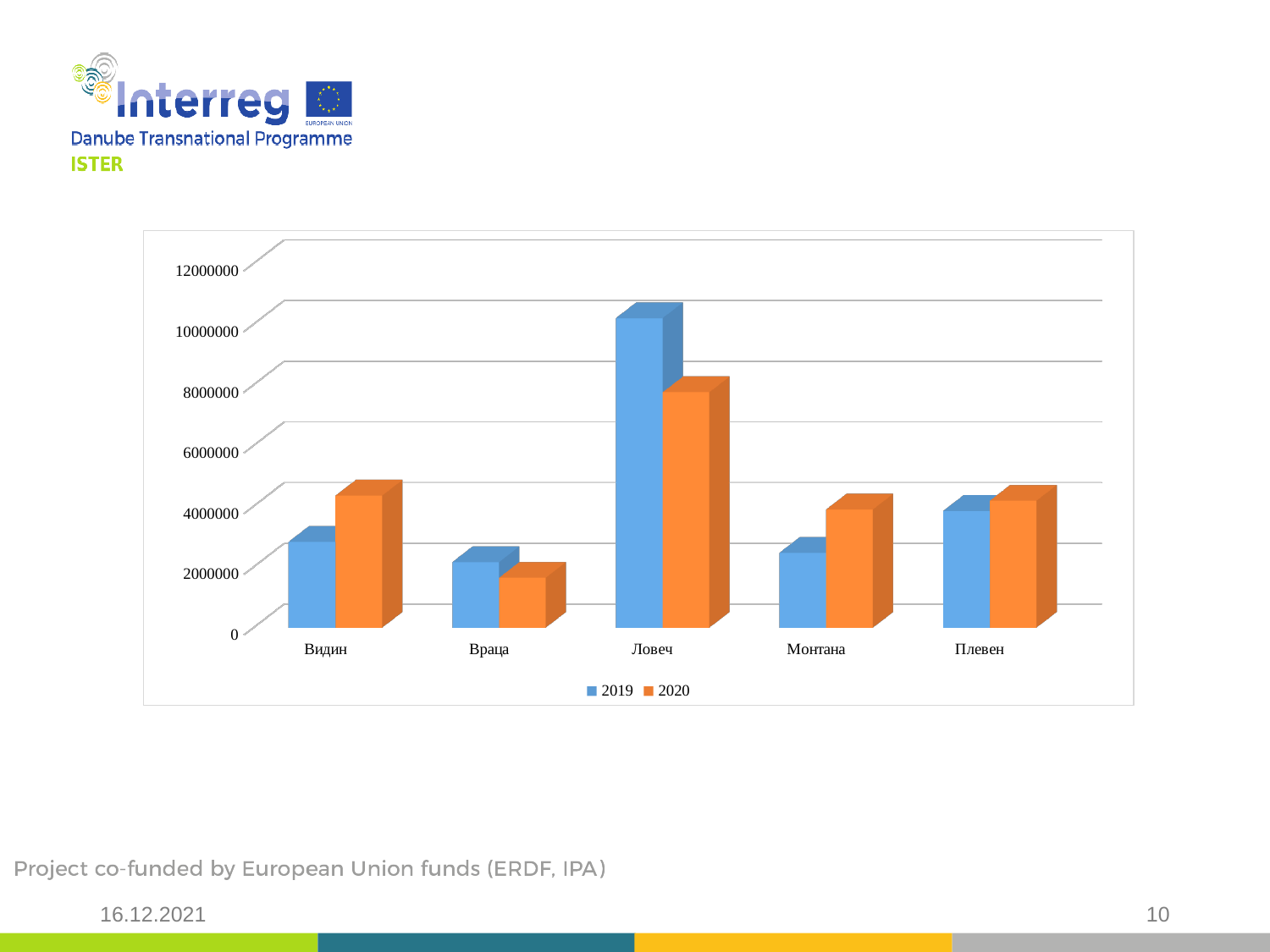
Is the 2019 value for Монтана greater or less than 4000000? less How many categories are shown on the x axis of the chart? 5 How many series does the chart's legend list? 2 Which category has the lowest value for the 2020 series? Враца What kind of chart is shown on the slide? bar chart Is the 2019 value for Ловеч greater or less than 8000000? greater Which category has the highest value for the 2020 series? Ловеч What are the two series names listed in the chart's legend? 2019 and 2020 Which category has the highest value for the 2019 series? Ловеч Is the 2020 value for Враца greater or less than 2000000? less For Ловеч, which series has the larger value, 2019 or 2020? 2019 For Видин, which series has the larger value, 2019 or 2020? 2020